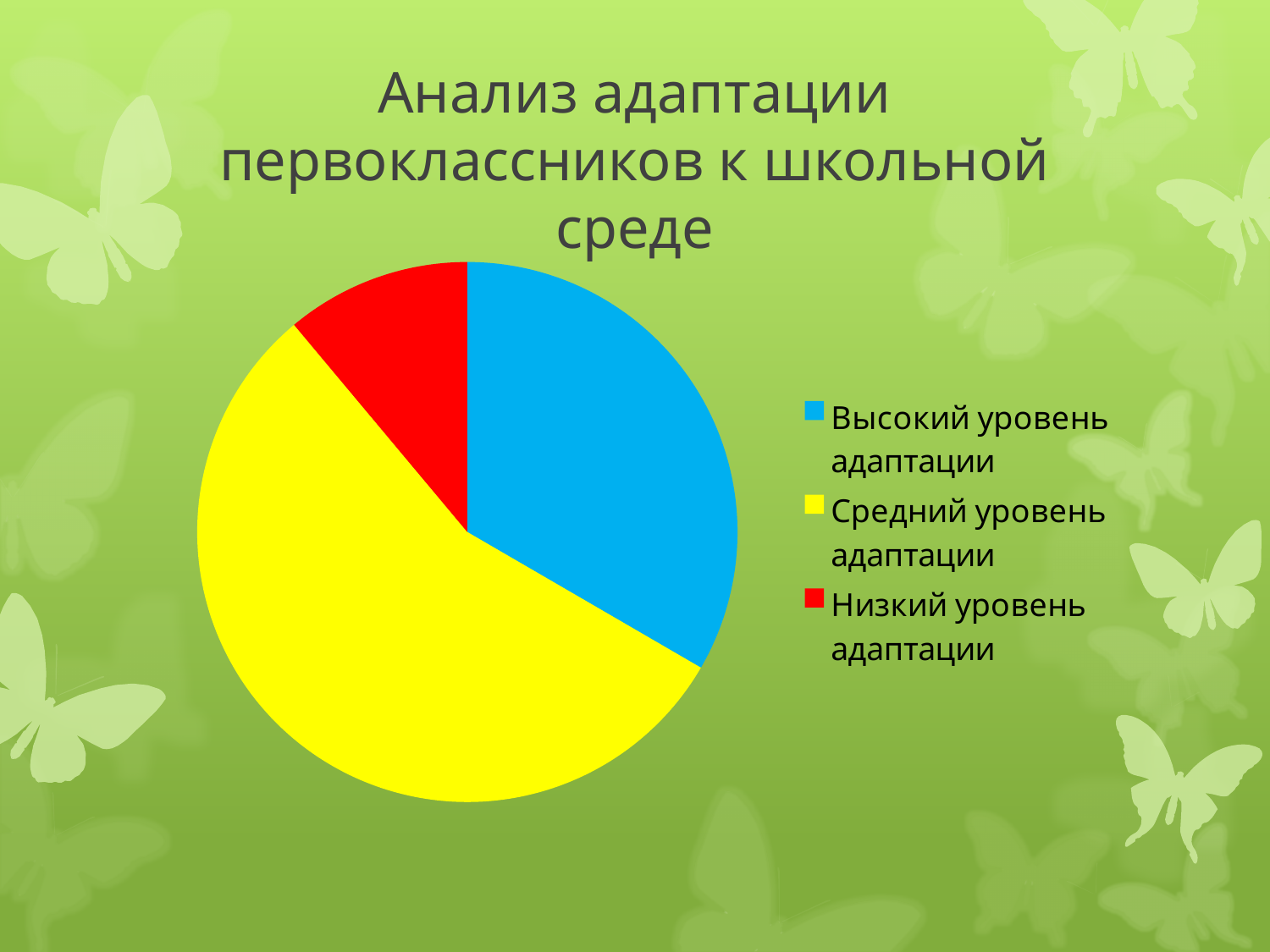
What is the title of the slide containing the pie chart? Анализ адаптации первоклассников к школьной среде How many slices does the pie chart have? 3 Which slice is larger: Высокий уровень адаптации or Средний уровень адаптации? Средний уровень адаптации Which category has the largest slice of the pie chart? Средний уровень адаптации Which category has the smallest slice of the pie chart? Низкий уровень адаптации What colour represents Низкий уровень адаптации in the pie chart? Red Which slice is larger: Высокий уровень адаптации or Низкий уровень адаптации? Высокий уровень адаптации What kind of chart is shown on the slide? Pie chart How many entries does the legend of the pie chart list? 3